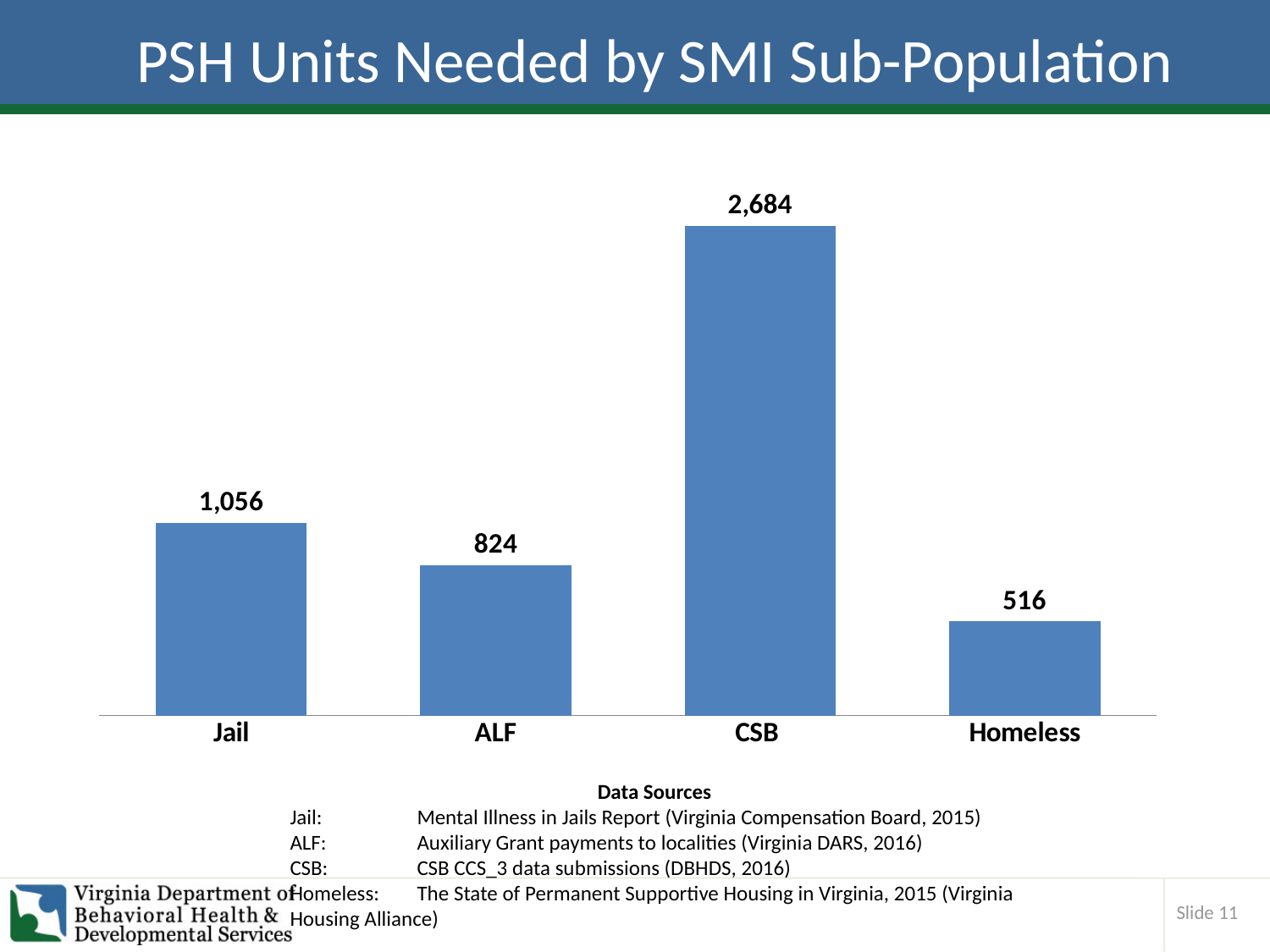
What kind of chart is shown on the slide? Bar chart How many sub-population categories are shown in the chart? 4 What is the title of the slide? PSH Units Needed by SMI Sub-Population Which is larger, the value for Jail or the value for ALF? Jail What is the value for ALF? 824 What is the value for Homeless? 516 What is the value for Jail? 1,056 What is the difference between the values for CSB and Jail? 1,628 Which sub-population has the highest number of PSH units needed? CSB What is the value for CSB? 2,684 What is the difference between the values for ALF and Homeless? 308 Which sub-population has the lowest number of PSH units needed? Homeless